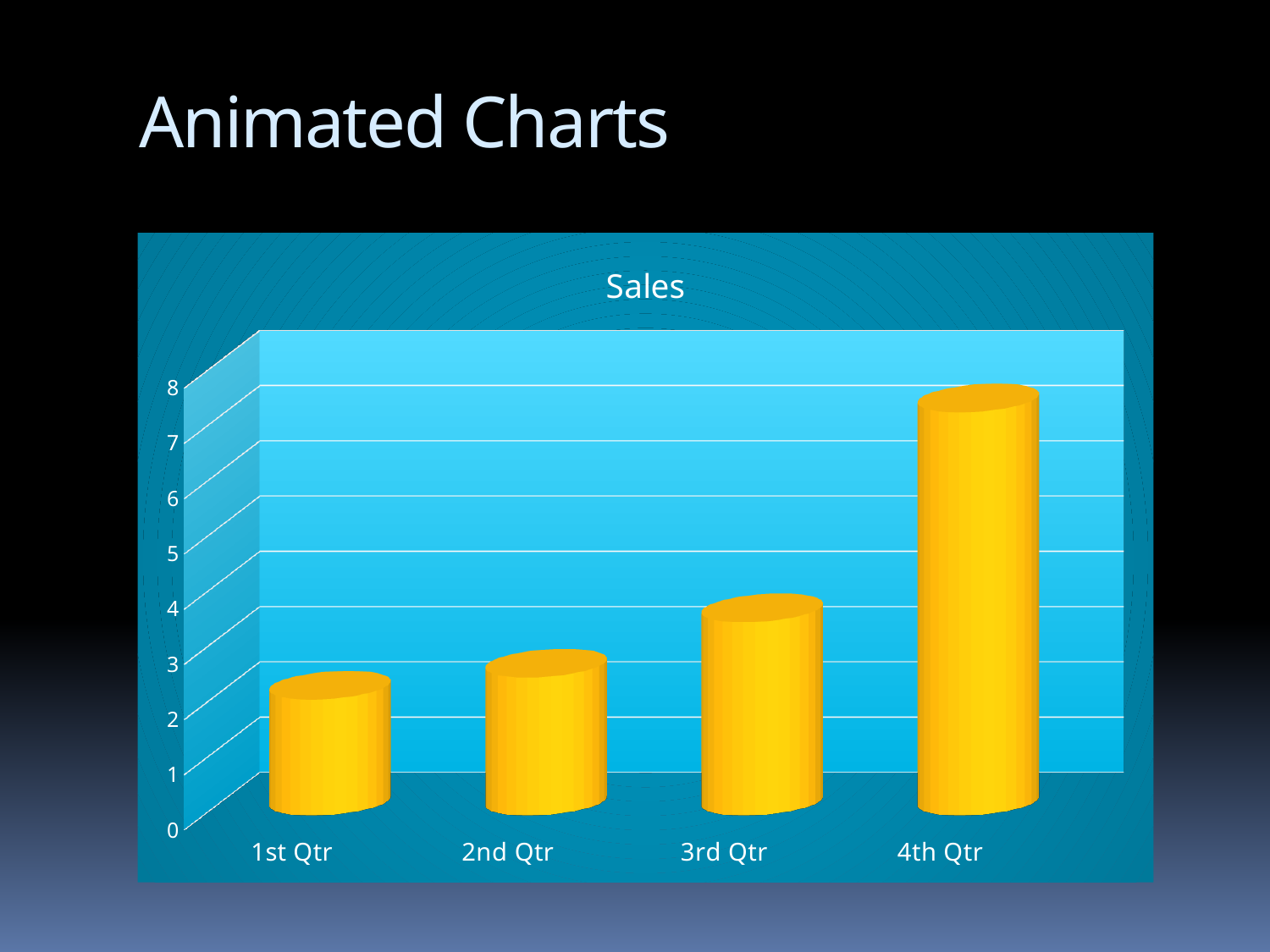
What is the title of the chart? Sales Which quarter has the highest value? 4th Qtr Is the value for 4th Qtr greater or less than 6? greater Which is larger, the value for 4th Qtr or the value for 1st Qtr? 4th Qtr How many categories are plotted on the x axis? 4 Do the values rise or fall from 1st Qtr to 4th Qtr? rise Which quarter has the lowest value? 1st Qtr What colour are the bars in the chart? yellow Which is larger, the value for 3rd Qtr or the value for 2nd Qtr? 3rd Qtr What kind of chart is shown on the slide? bar chart Is the value for 1st Qtr greater or less than 4? less Is the value for 3rd Qtr greater or less than 5? less